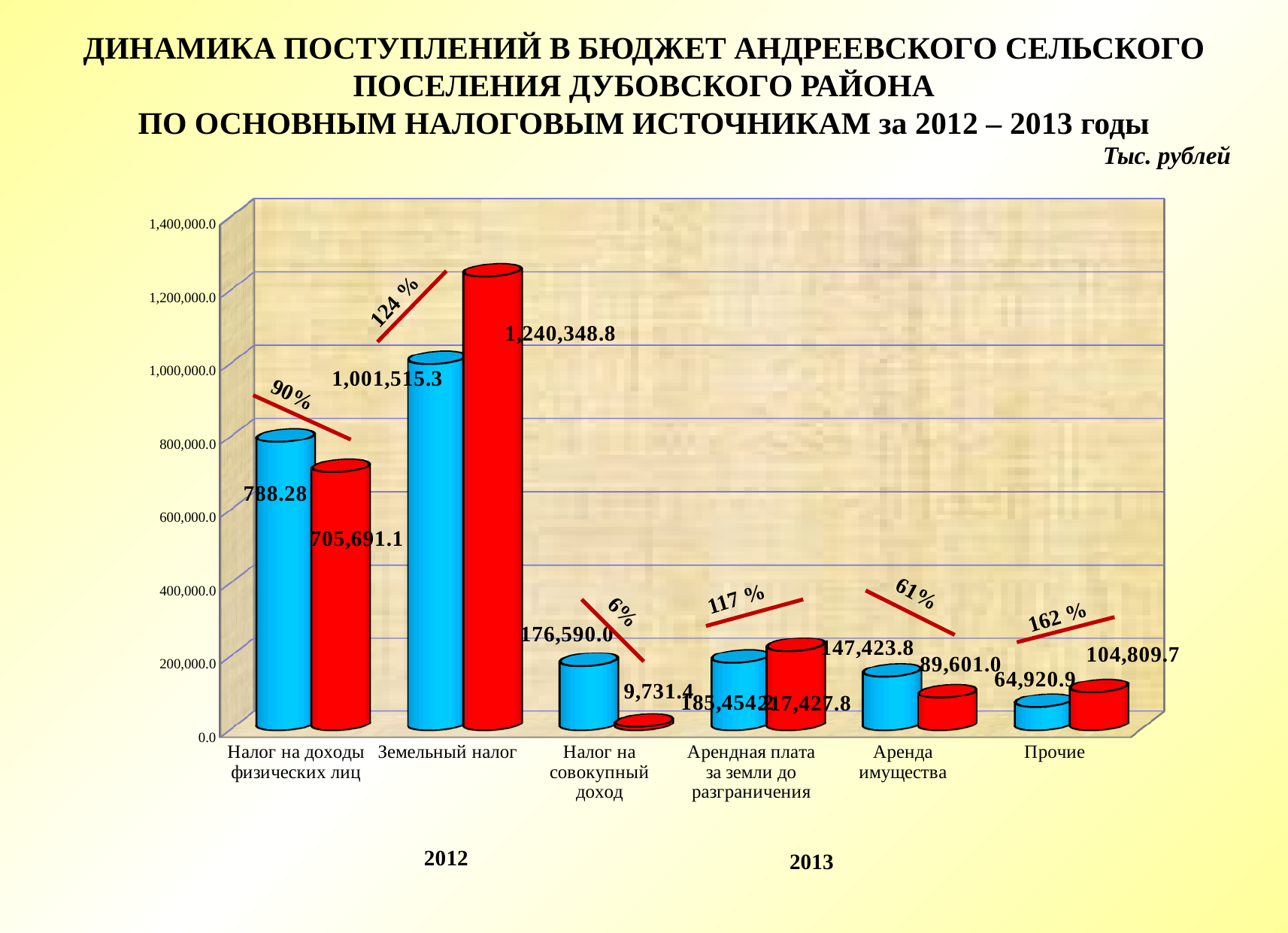
For Аренда имущества, which year has the larger value, 2012 or 2013? 2012 What is the 2013 value for Прочие? 104,809.7 What is the 2013 value for Земельный налог? 1,240,348.8 What kind of chart is shown on the slide? bar chart What is the 2012 value for Земельный налог? 1,001,515.3 Which category has the highest 2013 value? Земельный налог How many series does the chart show? 2 What is the difference between the 2013 and 2012 values for Земельный налог? 238,833.5 What percentage is annotated above the Земельный налог bars? 124 % Which category has the lowest 2013 value? Налог на совокупный доход What is the 2013 value for Налог на совокупный доход? 9,731.4 How many tax source categories are shown on the x axis? 6